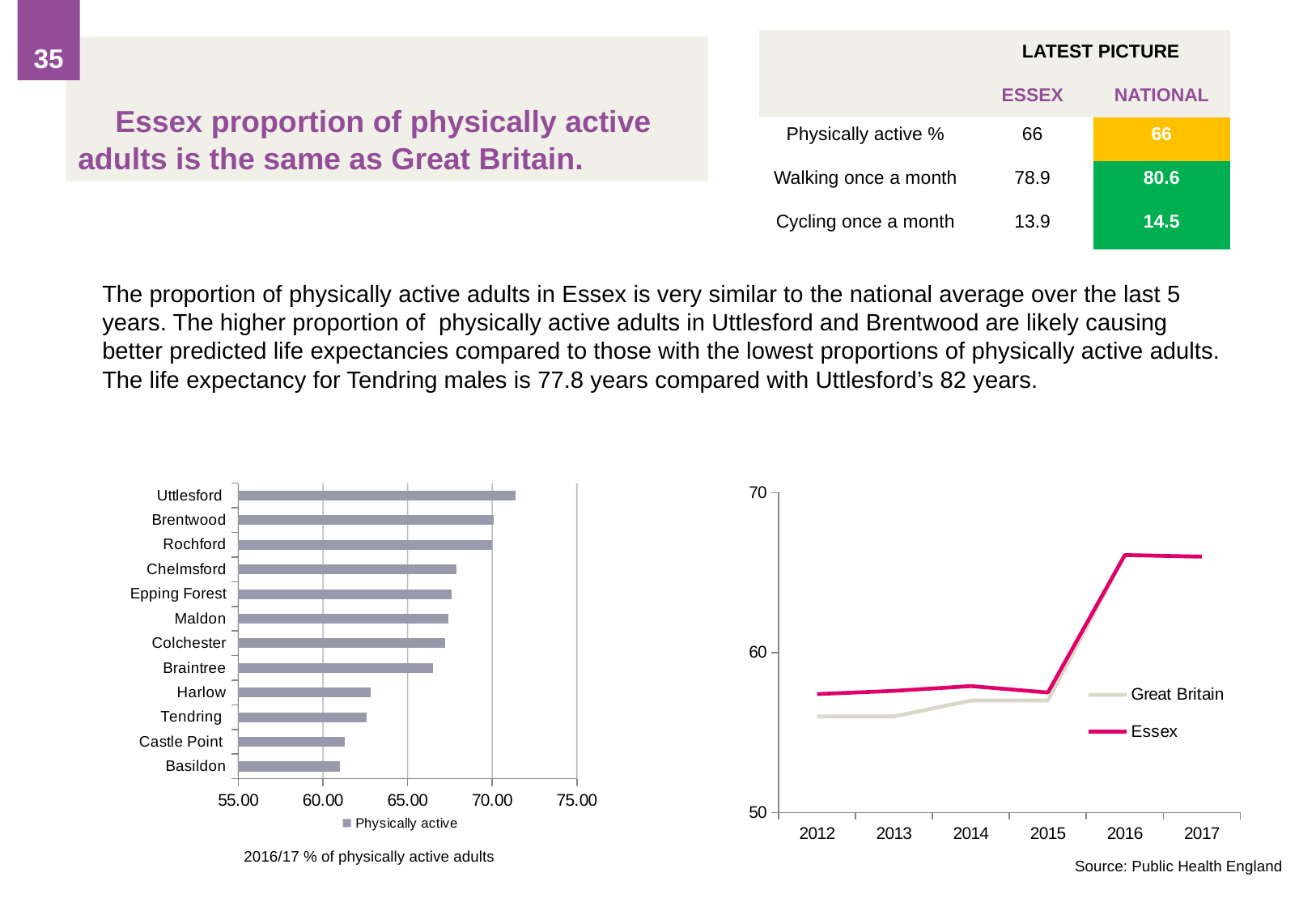
On the left chart (2016/17 % of physically active adults), how many districts are shown? 12 On the left chart (2016/17 % of physically active adults), which district has the highest value? Uttlesford On the left chart (2016/17 % of physically active adults), what is the legend entry? Physically active On the right chart (Great Britain vs Essex), how many years are shown on the x axis? 6 On the right chart (Great Britain vs Essex), is the Essex value for 2016 greater or less than 60? greater On the right chart (Great Britain vs Essex), does the Essex line rise or fall from 2015 to 2016? rise On the left chart (2016/17 % of physically active adults), is the value for Uttlesford greater or less than 70? greater What kind of chart is the left chart (2016/17 % of physically active adults)? bar chart On the left chart (2016/17 % of physically active adults), is the value for Basildon greater or less than 65? less On the left chart (2016/17 % of physically active adults), which is larger, the value for Uttlesford or the value for Harlow? Uttlesford On the right chart (Great Britain vs Essex), how many series does the legend list? 2